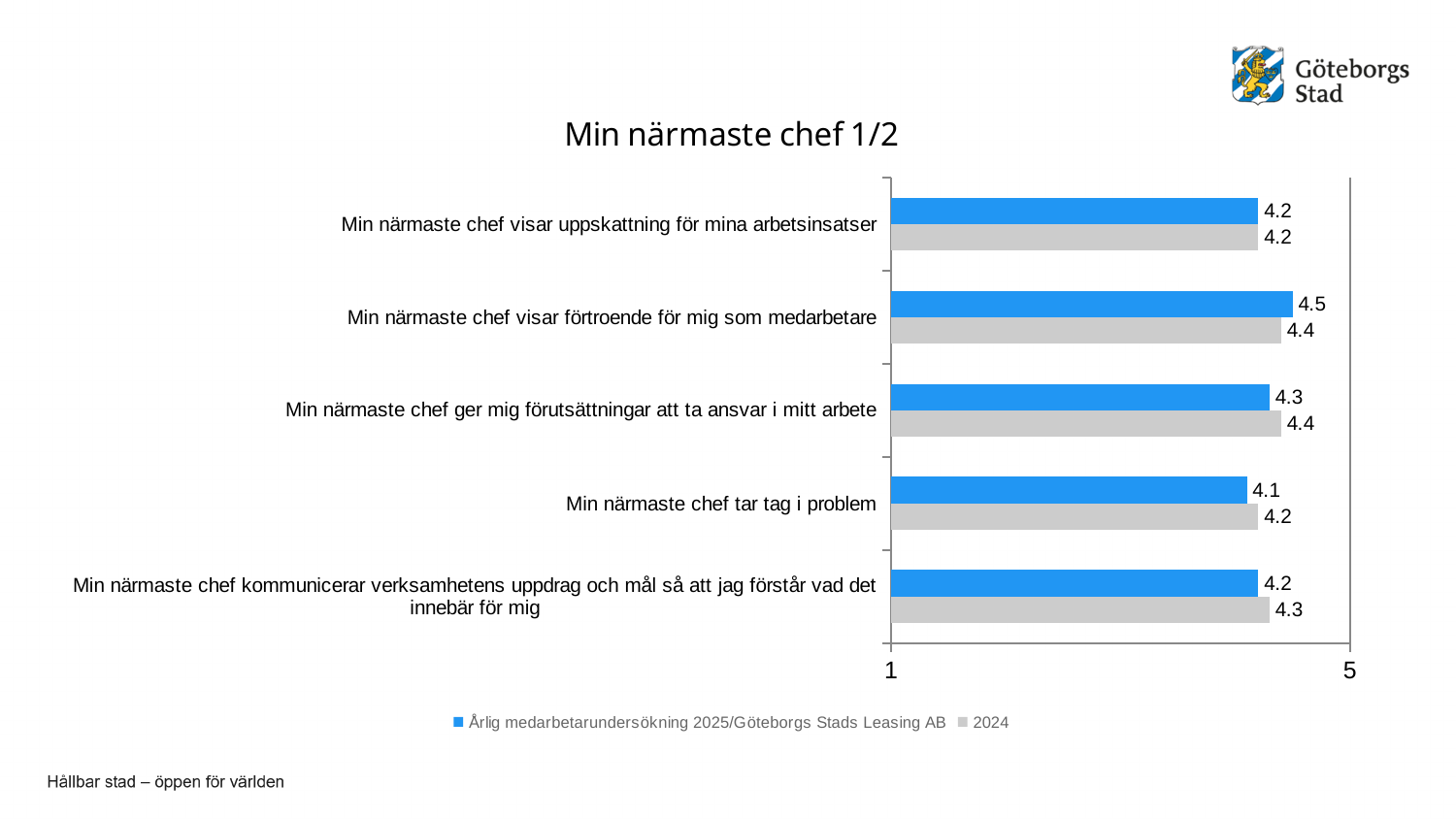
How many series does the legend list? 2 What is the difference between the 2025 and 2024 values for "Min närmaste chef tar tag i problem"? 0.1 What is the 2024 value for "Min närmaste chef ger mig förutsättningar att ta ansvar i mitt arbete"? 4.4 For "Min närmaste chef visar förtroende för mig som medarbetare", which is larger: the 2025 value or the 2024 value? 2025 Which category has the highest 2025 (blue) value? Min närmaste chef visar förtroende för mig som medarbetare What kind of chart is shown on the slide? Bar chart What is the 2025 value for "Min närmaste chef visar förtroende för mig som medarbetare"? 4.5 For "Min närmaste chef ger mig förutsättningar att ta ansvar i mitt arbete", which is larger: the 2025 value or the 2024 value? 2024 Which category has the lowest 2025 (blue) value? Min närmaste chef tar tag i problem What is the 2024 value for "Min närmaste chef tar tag i problem"? 4.2 What is the title of the chart? Min närmaste chef 1/2 How many categories are shown in the chart? 5